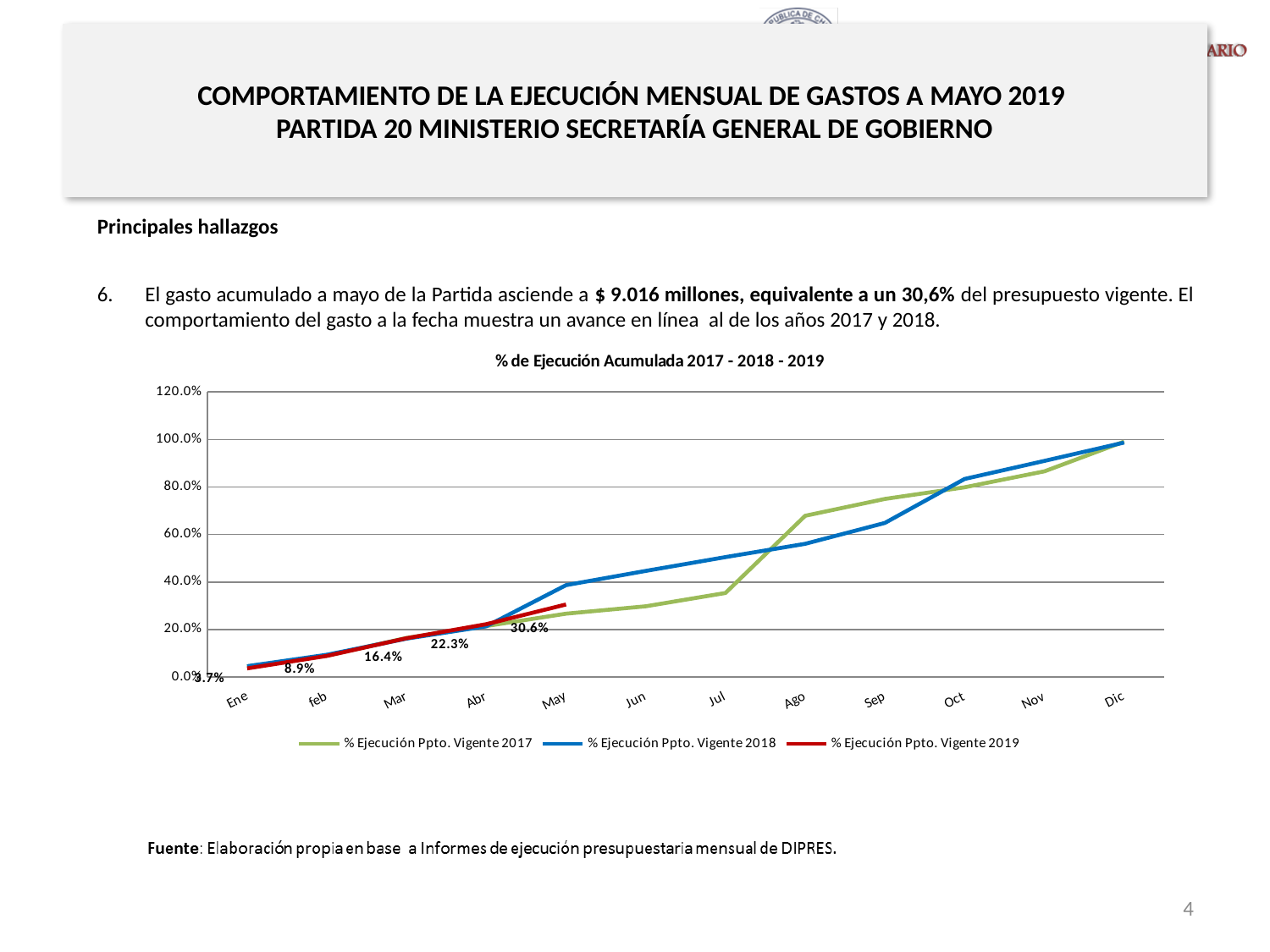
How many series does the chart legend list? 3 What is the value of % Ejecución Ppto. Vigente 2019 for Abr? 22.3% What kind of chart is shown on the slide? line chart What is the value of % Ejecución Ppto. Vigente 2019 for Feb? 8.9% Is the value for % Ejecución Ppto. Vigente 2017 in Ago greater or less than 60%? greater How many months are shown along the x axis of the chart? 12 What is the title of the chart? % de Ejecución Acumulada 2017 - 2018 - 2019 What is the value of % Ejecución Ppto. Vigente 2019 for Mar? 16.4% Which month has the highest value for the % Ejecución Ppto. Vigente 2019 series? May What is the value of % Ejecución Ppto. Vigente 2019 for May? 30.6% Do the values of the % Ejecución Ppto. Vigente 2018 series rise or fall from Ene to Dic? rise What is the difference between the 2019 values for May and Abr? 8.3%